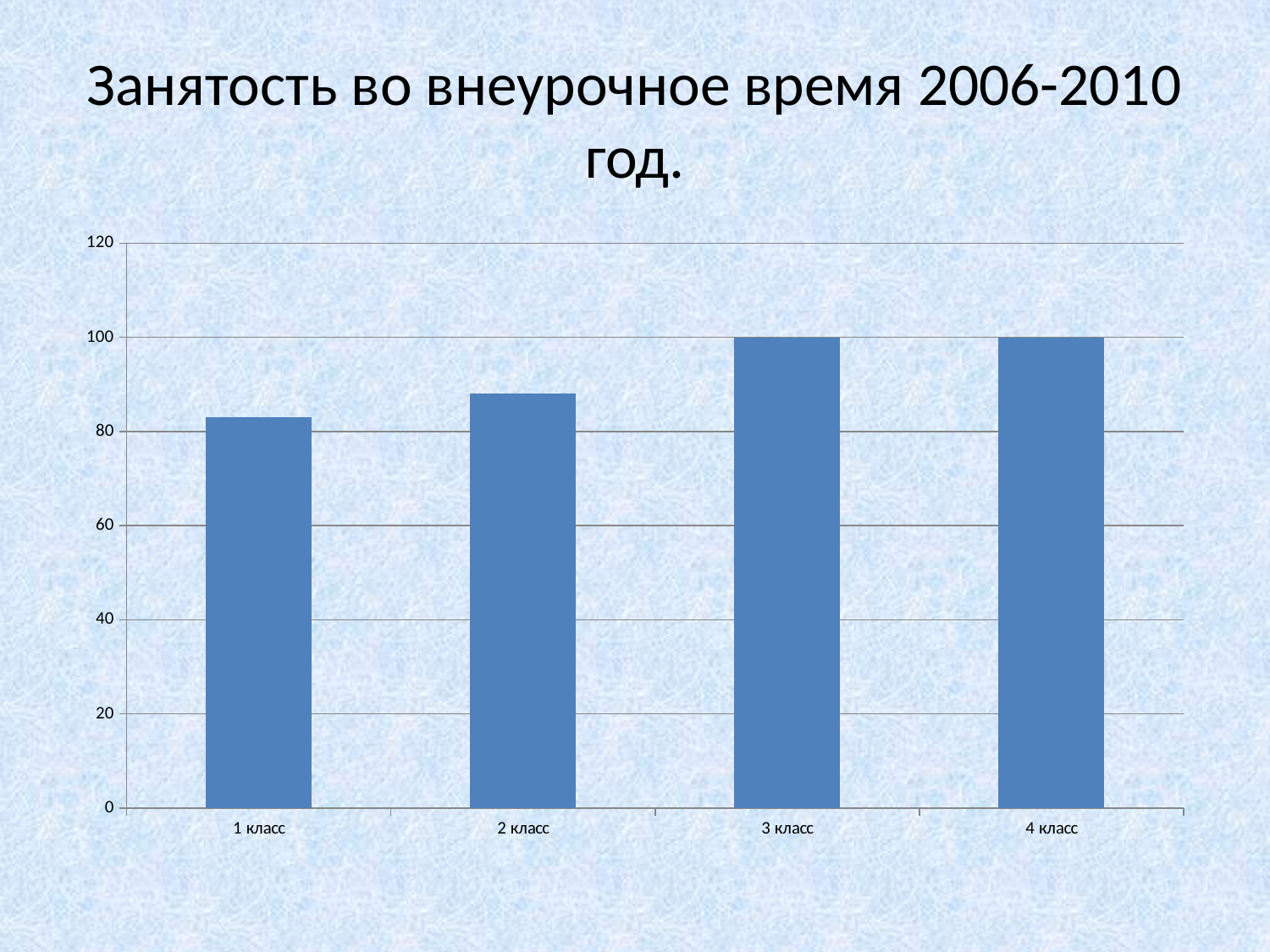
Is the value for 2 класс greater or less than 80? greater What is the value for 4 класс? 100 Is the value for 1 класс greater or less than 100? less How many categories are shown on the x axis of the chart? 4 Is the value for 2 класс greater or less than 100? less What is the title of the chart on the slide? Занятость во внеурочное время 2006-2010 год. Which is larger, the value for 1 класс or the value for 2 класс? 2 класс Do the values rise or fall from 1 класс to 4 класс? rise Which category has the lowest value? 1 класс What is the value for 3 класс? 100 What kind of chart is shown on the slide? bar chart